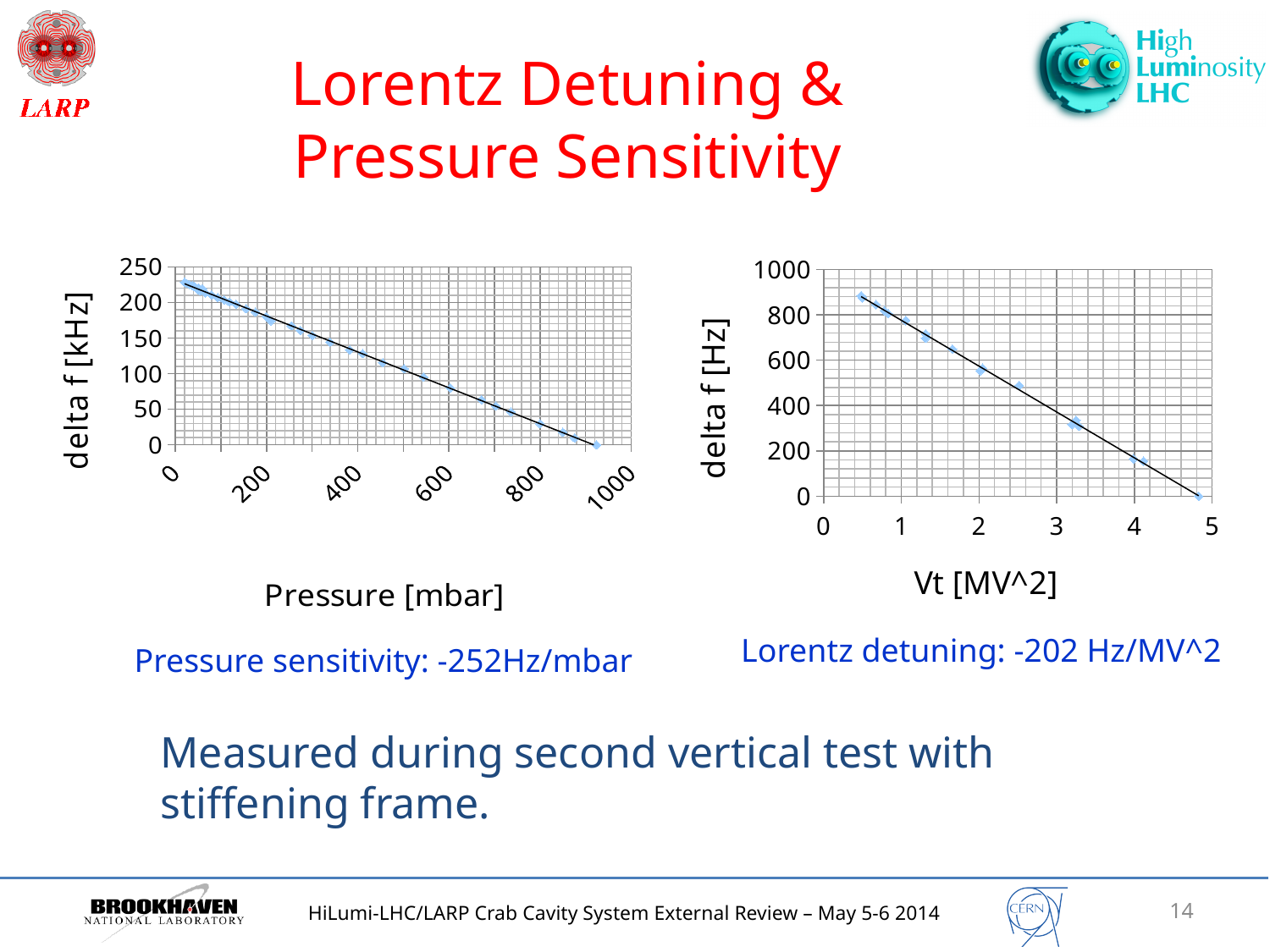
In the left chart, is the delta f value at a pressure of about 400 mbar greater or less than 100 kHz? greater What is the y-axis label of the right chart? delta f [Hz] What kind of chart is the left chart (delta f vs Pressure)? scatter plot with a fitted line What is the x-axis label of the left chart? Pressure [mbar] In the left chart, do the delta f values rise or fall as pressure increases? fall In the right chart, is the delta f value at Vt of about 4 MV^2 greater or less than 400 Hz? less In the right chart, do the delta f values rise or fall as Vt increases? fall What kind of chart is the right chart (delta f vs Vt)? scatter plot with a fitted line In the right chart, is delta f larger at Vt of about 1 MV^2 or at about 3 MV^2? about 1 MV^2 In the right chart, is the delta f value at Vt of about 2 MV^2 greater or less than 400 Hz? greater In the left chart, is delta f larger at a pressure of about 200 mbar or at about 800 mbar? about 200 mbar